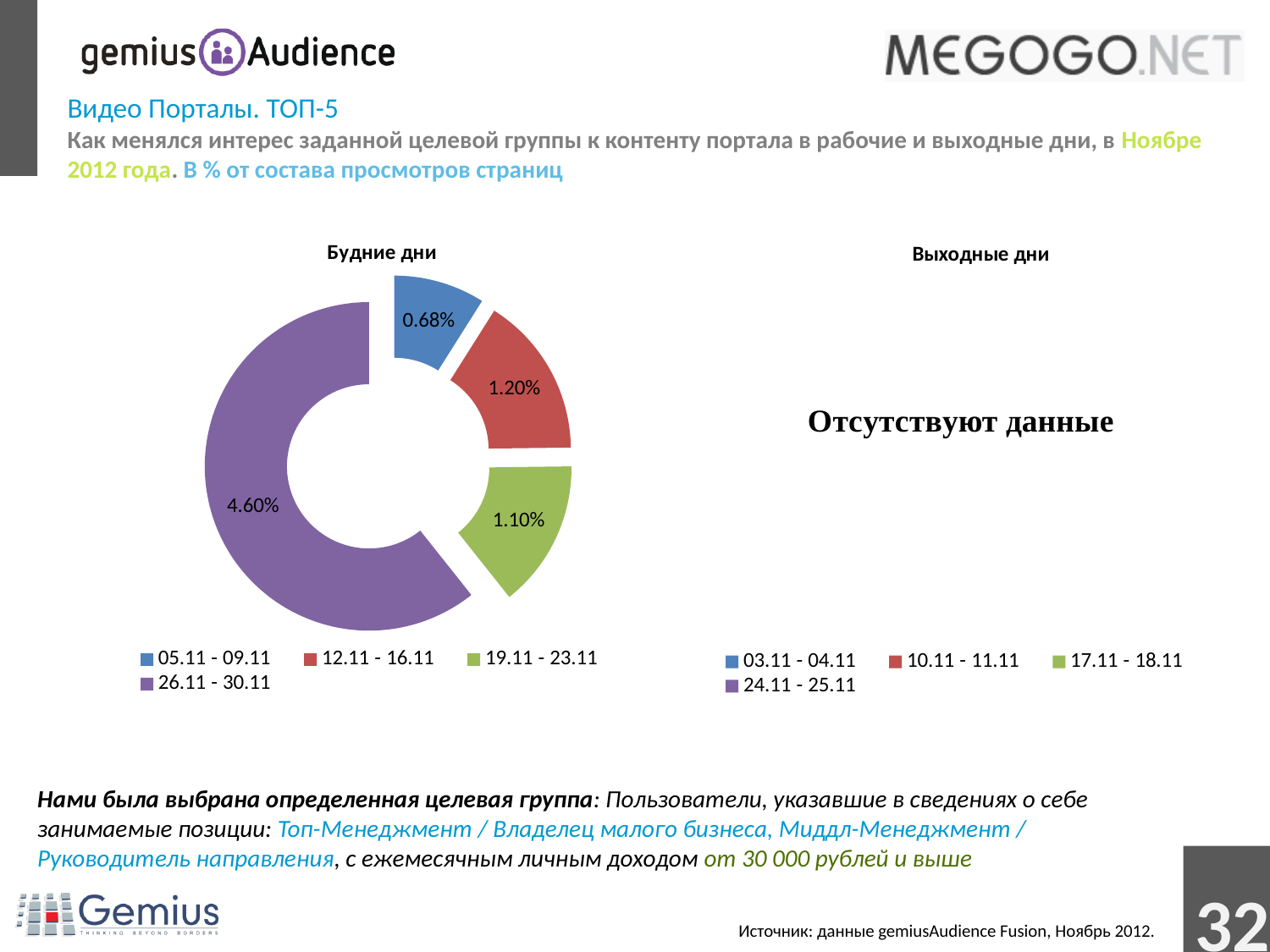
In the 'Будние дни' chart, what is the difference between the values for 26.11 - 30.11 and 12.11 - 16.11? 3.40% In the 'Будние дни' chart, what is the value for 05.11 - 09.11? 0.68% What kind of chart is the 'Будние дни' chart? Doughnut chart In the 'Будние дни' chart, what is the value for 19.11 - 23.11? 1.10% In the 'Будние дни' chart, which period has the smallest share? 05.11 - 09.11 In the 'Будние дни' chart, what is the value for 26.11 - 30.11? 4.60% In the 'Будние дни' chart, what is the value for 12.11 - 16.11? 1.20% In the 'Будние дни' chart, which is larger: the value for 12.11 - 16.11 or for 19.11 - 23.11? 12.11 - 16.11 What does the 'Выходные дни' chart show instead of data? Отсутствуют данные How many entries does the legend of the 'Выходные дни' chart list? 4 In the 'Будние дни' chart, which period has the largest share? 26.11 - 30.11 How many periods are shown in the 'Будние дни' chart? 4